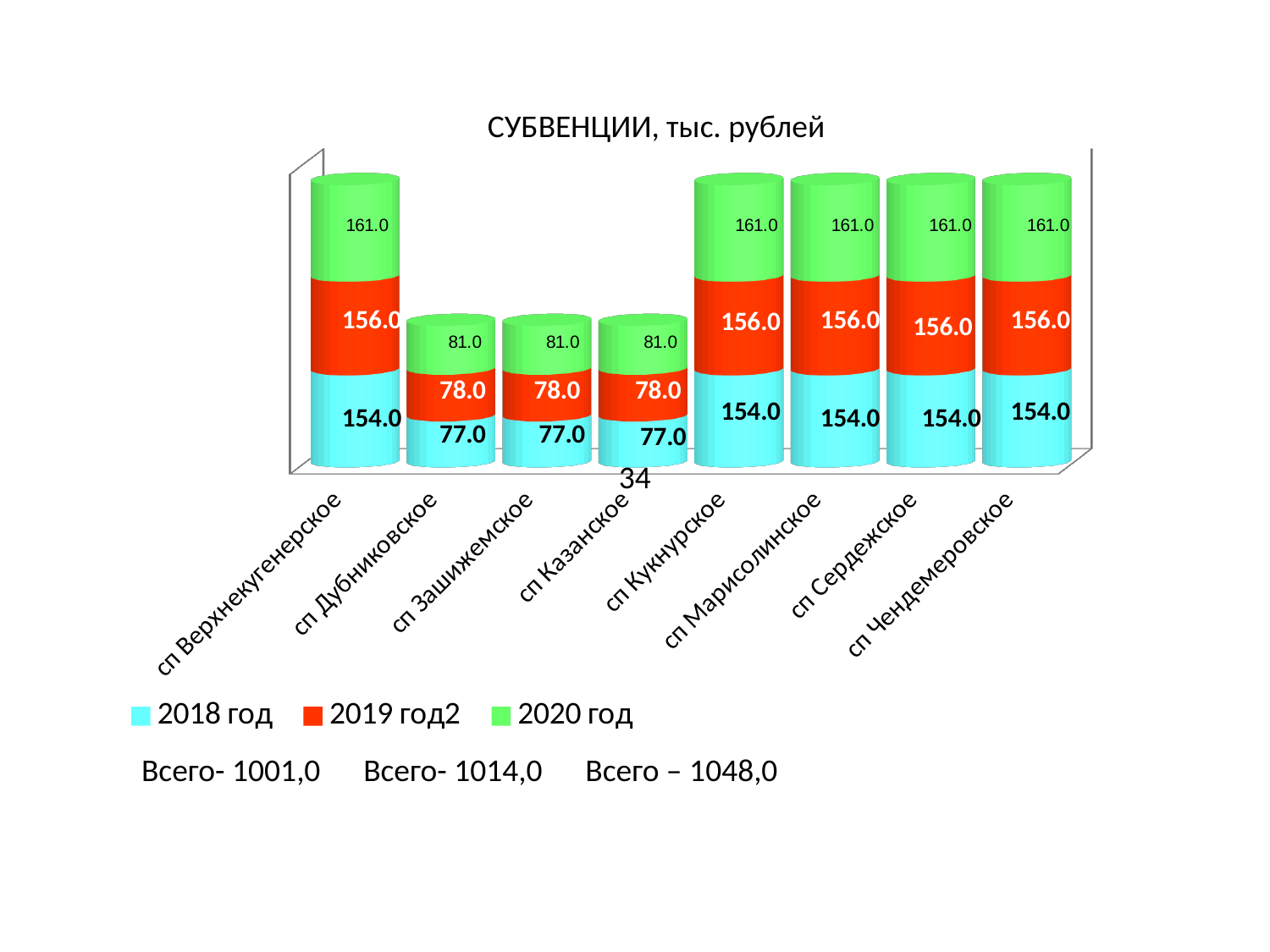
What is the total of the stacked bar for сп Сердежское? 471.0 How many series does the legend list? 3 How many categories are shown on the x axis? 8 What is the value for сп Дубниковское in the 2018 год series? 77.0 What is the value for сп Чендемеровское in the 2019 год2 series? 156.0 What is the total of the stacked bar for сп Зашижемское? 236.0 Which is larger: the 2018 год value for сп Верхнекугенерское or for сп Казанское? сп Верхнекугенерское What is the difference between the 2020 год values for сп Марисолинское and сп Дубниковское? 80.0 What kind of chart is shown on the slide? Stacked bar chart What is the title of the chart? СУБВЕНЦИИ, тыс. рублей What is the value for сп Казанское in the 2019 год2 series? 78.0